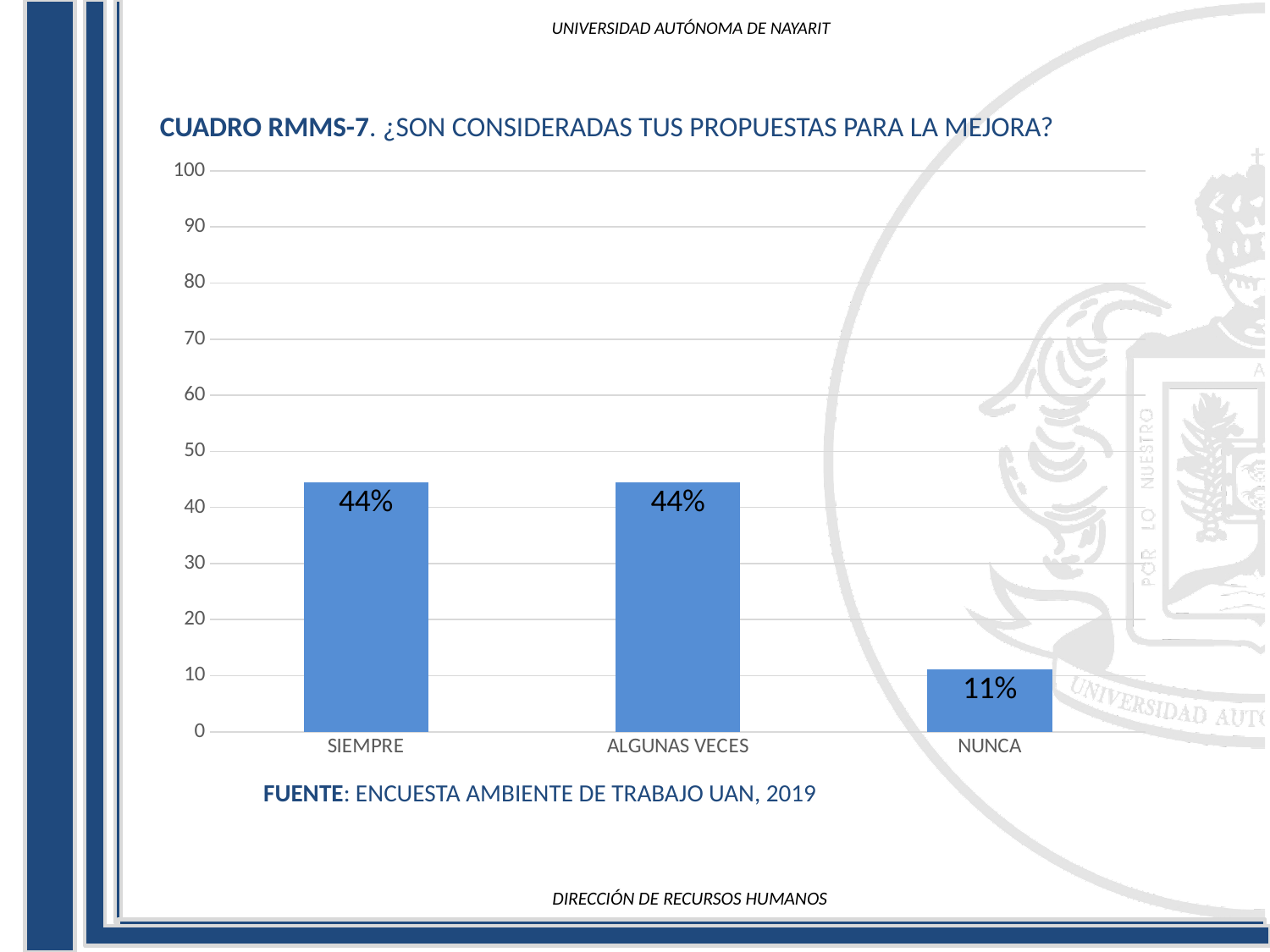
What is the value for SIEMPRE? 44% Is the value for NUNCA greater or less than 20? less What is the highest value shown on the y axis? 100 What is the difference between the values for SIEMPRE and NUNCA? 33% What is the source cited below the chart? ENCUESTA AMBIENTE DE TRABAJO UAN, 2019 What is the value for ALGUNAS VECES? 44% What is the value for NUNCA? 11% Which category has the lowest value? NUNCA How many categories are shown on the x axis? 3 Which is larger, the value for ALGUNAS VECES or the value for NUNCA? ALGUNAS VECES What kind of chart is shown on the slide? bar chart Is the value for SIEMPRE greater or less than 40? greater